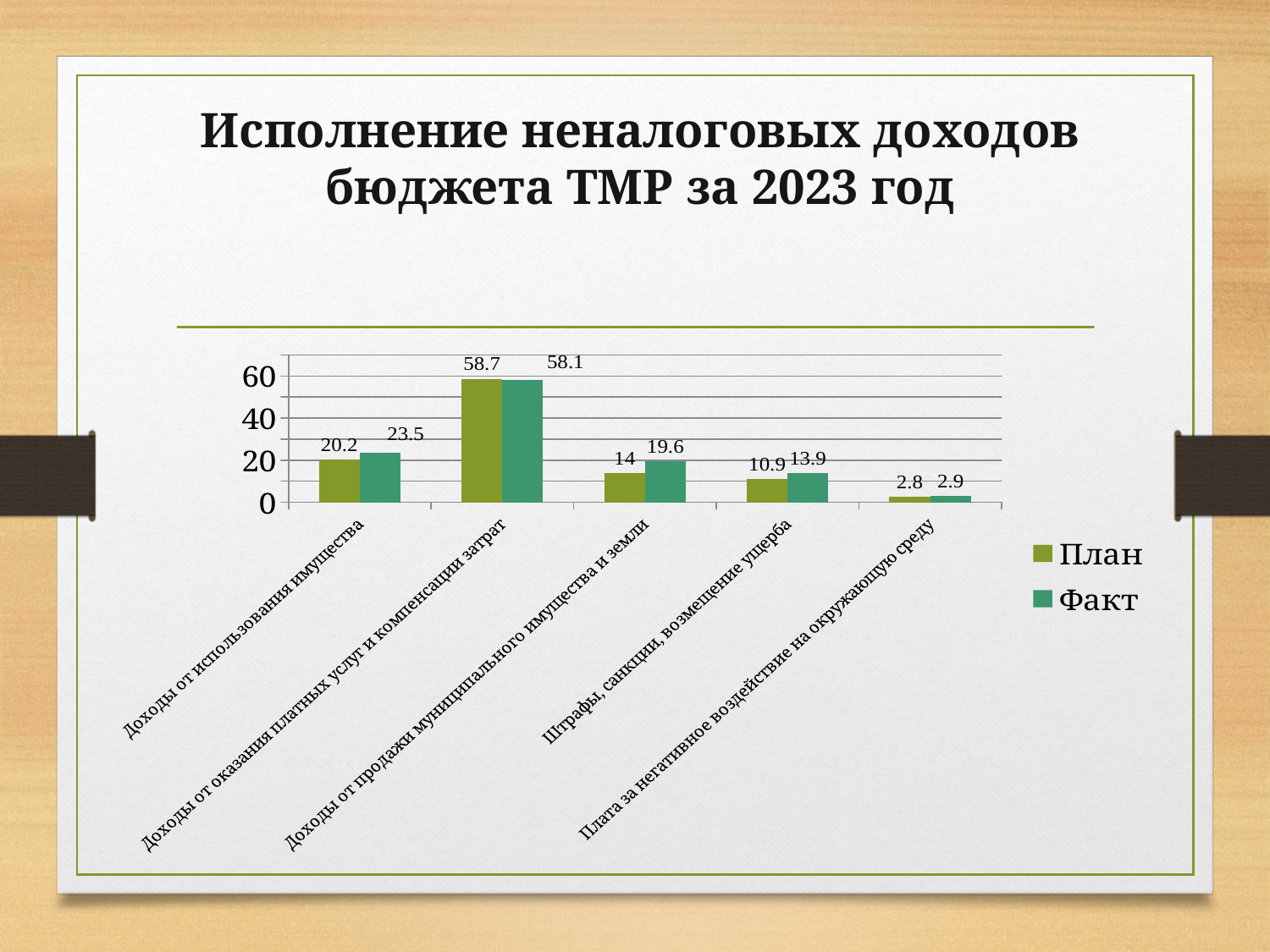
For Доходы от продажи муниципального имущества и земли, which is larger: План or Факт? Факт Is the Факт value for Доходы от оказания платных услуг и компенсации затрат greater or less than 40? greater What is the План value for Доходы от использования имущества? 20.2 How many categories are shown on the x axis? 5 Which category has the lowest План value? Плата за негативное воздействие на окружающую среду Which category has the highest Факт value? Доходы от оказания платных услуг и компенсации затрат What kind of chart is shown on the slide? bar chart What is the difference between the Факт and План values for Доходы от использования имущества? 3.3 What is the Факт value for Доходы от продажи муниципального имущества и земли? 19.6 How many series does the legend list? 2 What is the Факт value for Штрафы, санкции, возмещение ущерба? 13.9 What is the difference between the План and Факт values for Доходы от оказания платных услуг и компенсации затрат? 0.6